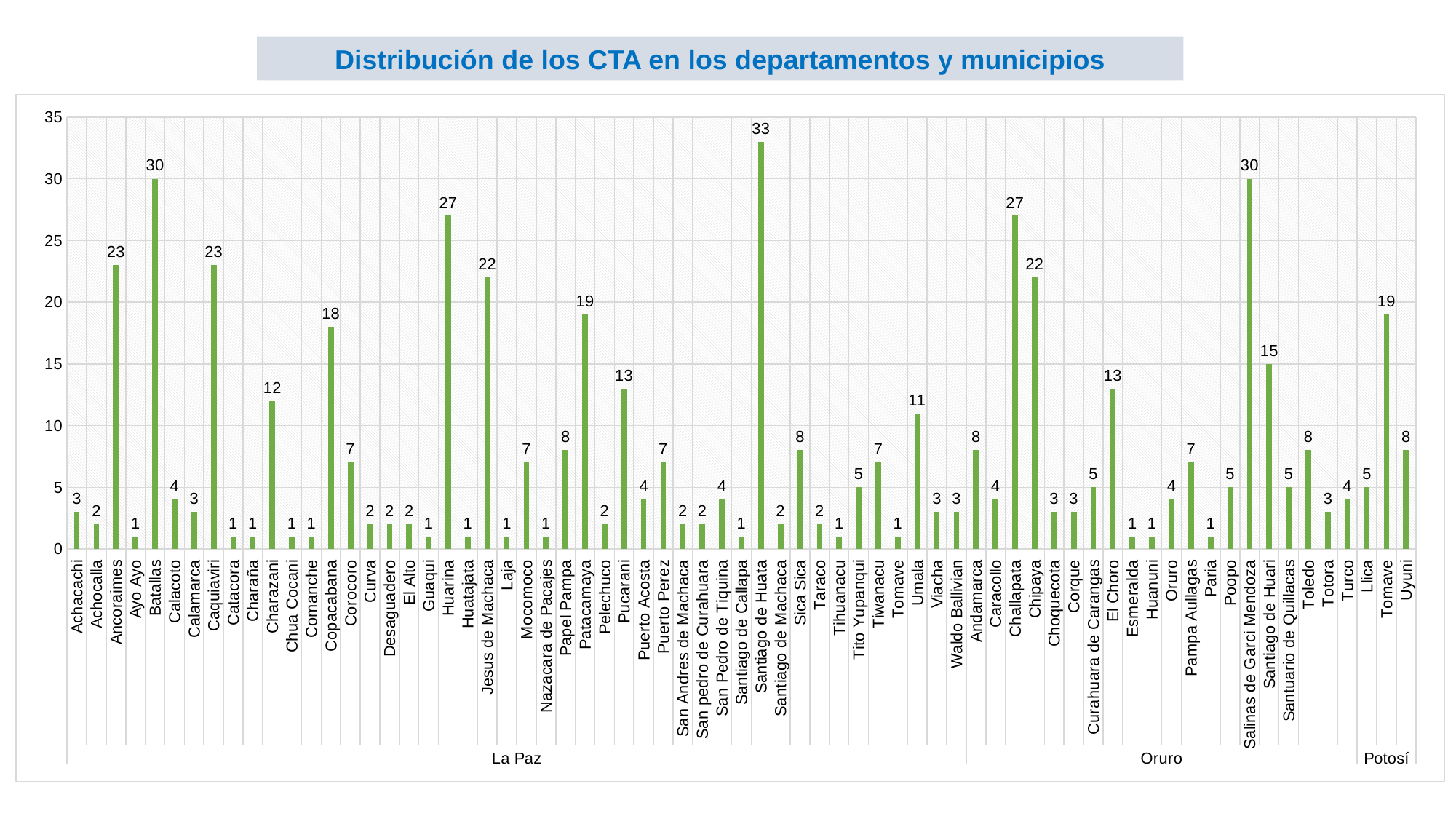
What is the value for Santiago de Huata? 33 What is the value for Batallas? 30 How many departments are the municipalities grouped into along the x axis? 3 What is the value for Uyuni? 8 Which municipality has the highest value in the chart? Santiago de Huata What type of chart is shown on the slide? bar chart Which has a larger value, Chipaya or Santiago de Huari? Chipaya What is the value for Challapata? 27 Is the value for Salinas de Garci Mendoza greater or less than 25? greater What is the title of the chart? Distribución de los CTA en los departamentos y municipios What is the value for El Choro? 13 What is the difference between the values for Huarina and Copacabana? 9